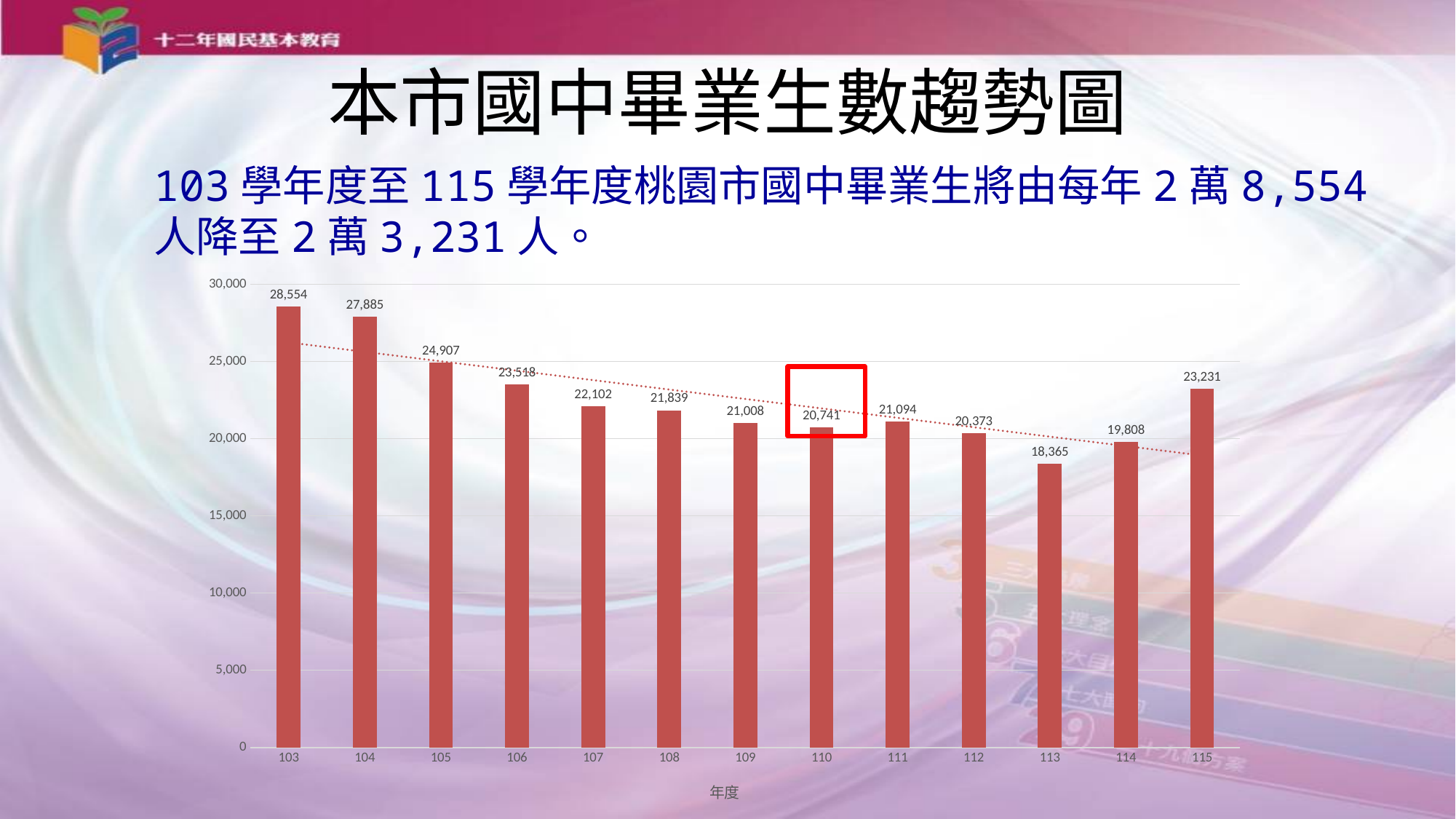
What kind of chart is this? bar chart Is the value for year 113 greater or less than 20,000? less What is the value for year 103? 28,554 What is the value for year 115? 23,231 What is the label of the x axis? 年度 How many years are shown on the x axis? 13 Do the values generally rise or fall from year 103 to year 113? fall What is the difference between the values for year 103 and year 115? 5,323 Which year has the lowest value? 113 What is the value for year 110? 20,741 Which year has the highest value? 103 Which is larger, the value for year 111 or the value for year 112? 111